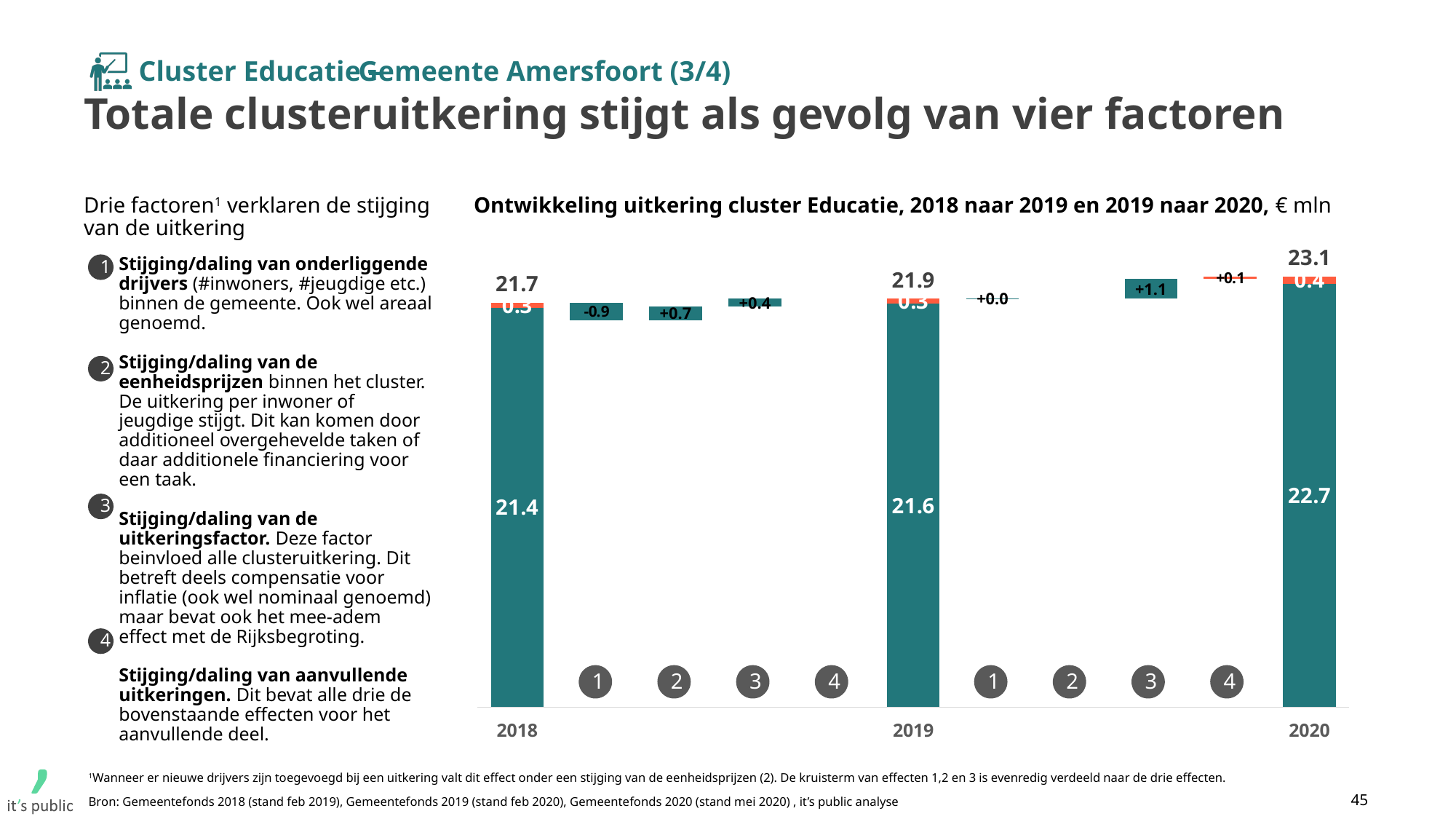
What value is printed inside the large teal segment of the 2019 bar? 21.6 What value is printed on the small orange segment at the top of the 2020 bar? 0.4 Which year has the highest total uitkering on the chart? 2020 Which year has the lowest total uitkering on the chart? 2018 What is the total uitkering for cluster Educatie in 2020 shown on the chart? 23.1 What is the effect of factor 1 on the uitkering from 2018 to 2019? -0.9 By how much does the total uitkering in 2020 exceed the total in 2018? 1.4 What is the total uitkering for cluster Educatie in 2018 shown on the chart? 21.7 What is the effect of factor 3 on the uitkering from 2019 to 2020? +1.1 Does the total uitkering rise or fall from 2018 to 2020? Rise Between 2018 and 2019, which factor has the larger positive effect: factor 2 or factor 3? Factor 2 What unit is stated in the chart title for the values? € mln